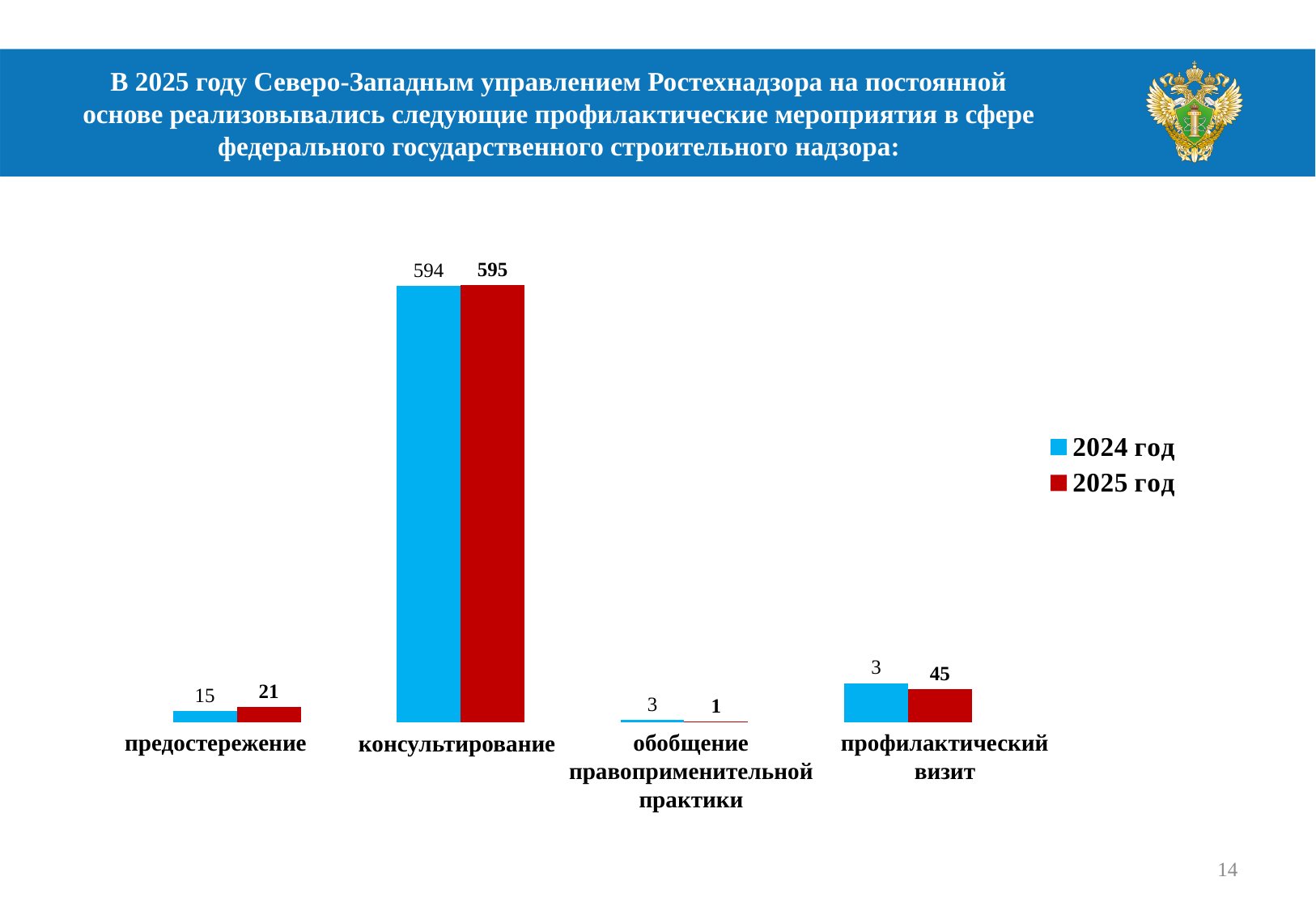
Which category has the lowest value in the 2025 год series? обобщение правоприменительной практики What is the value for профилактический визит in the 2025 год series? 45 Which category has the highest value in the 2025 год series? консультирование What is the value for консультирование in the 2024 год series? 594 How many series does the legend list? 2 What is the value for предостережение in the 2025 год series? 21 How many categories are shown on the x axis of the chart? 4 What kind of chart is shown on the slide? bar chart What is the difference between the 2025 год and 2024 год values for предостережение? 6 For профилактический визит, which series has the larger value, 2024 год or 2025 год? 2024 год What is the value for обобщение правоприменительной практики in the 2024 год series? 3